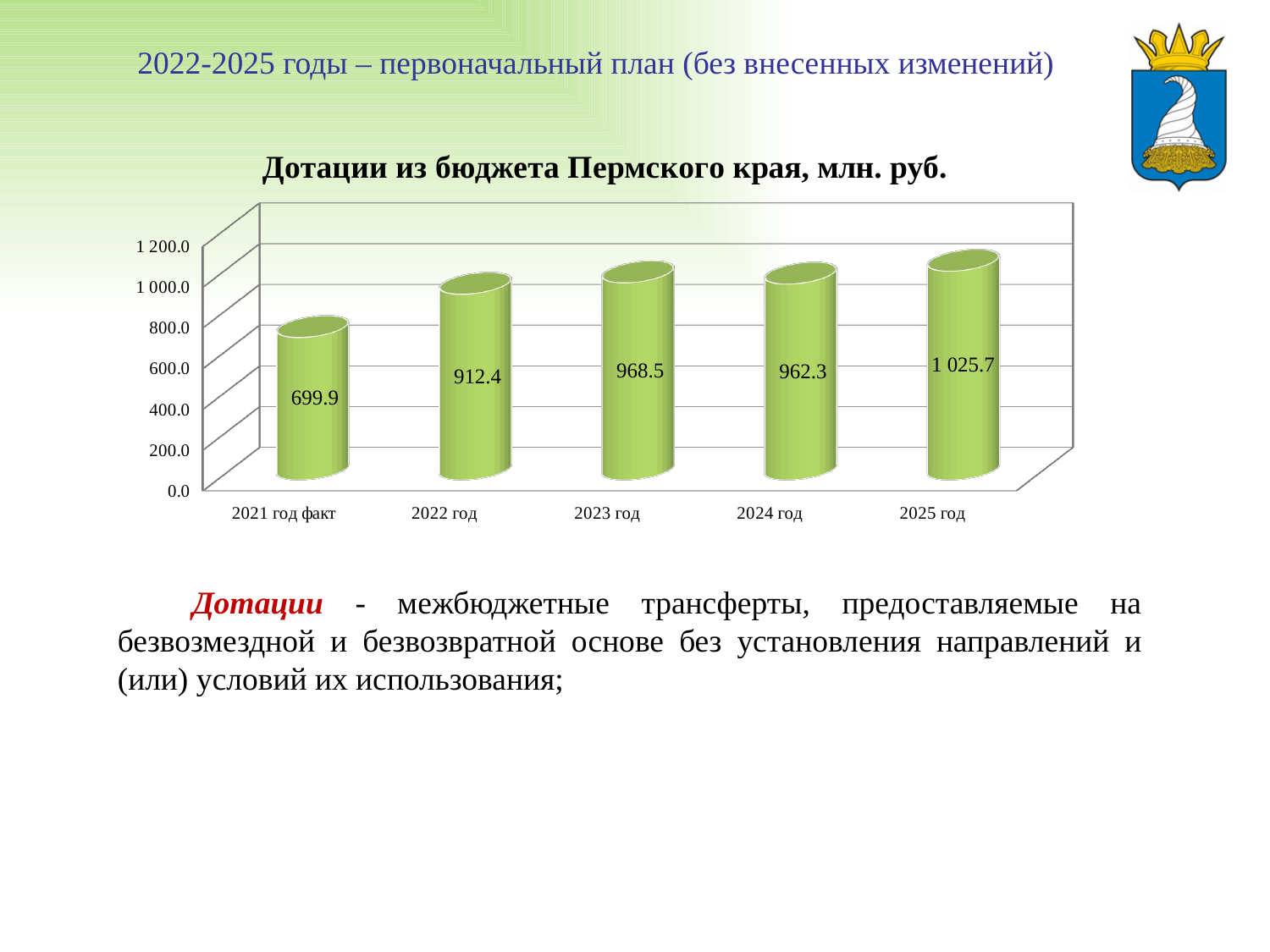
How many categories are shown on the x axis? 5 What is the value for 2021 год факт? 699.9 Which is larger, the value for 2022 год or the value for 2025 год? 2025 год What is the value for 2025 год? 1 025.7 Which year has the lowest value? 2021 год факт Which year has the highest value? 2025 год What kind of chart is shown? bar chart What is the difference between the values for 2025 год and 2023 год? 57.2 What is the title of the chart? Дотации из бюджета Пермского края, млн. руб. What is the value for 2023 год? 968.5 Is the value for 2024 год greater or less than 800.0? greater What is the difference between the values for 2022 год and 2021 год факт? 212.5